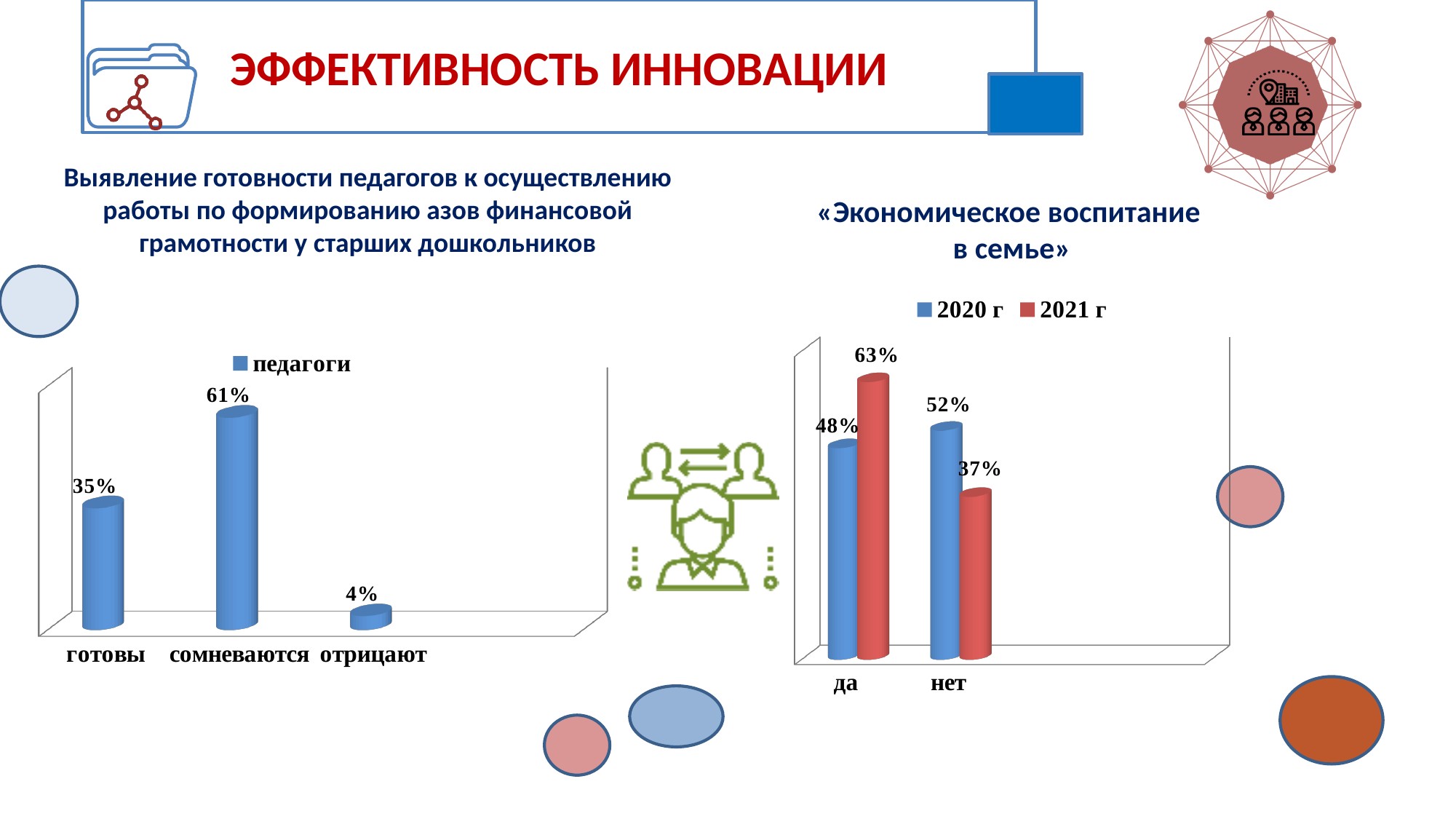
How many categories are shown in the left chart? 3 In the right chart, which is larger for нет: 2020 г or 2021 г? 2020 г In the right chart («Экономическое воспитание в семье»), what is the value for да in 2021 г? 63% In the left chart, which category has the lowest value? отрицают In the left chart, what is the value for готовы? 35% How many series does the legend of the right chart list? 2 In the right chart, what is the difference between the 2021 г and 2020 г values for да? 15% In the left chart, what is the value for сомневаются? 61% In the left chart, what is the difference between сомневаются and готовы? 26% In the right chart («Экономическое воспитание в семье»), what is the value for нет in 2020 г? 52% What type of chart is the left chart? bar chart In the left chart, which category has the highest value? сомневаются